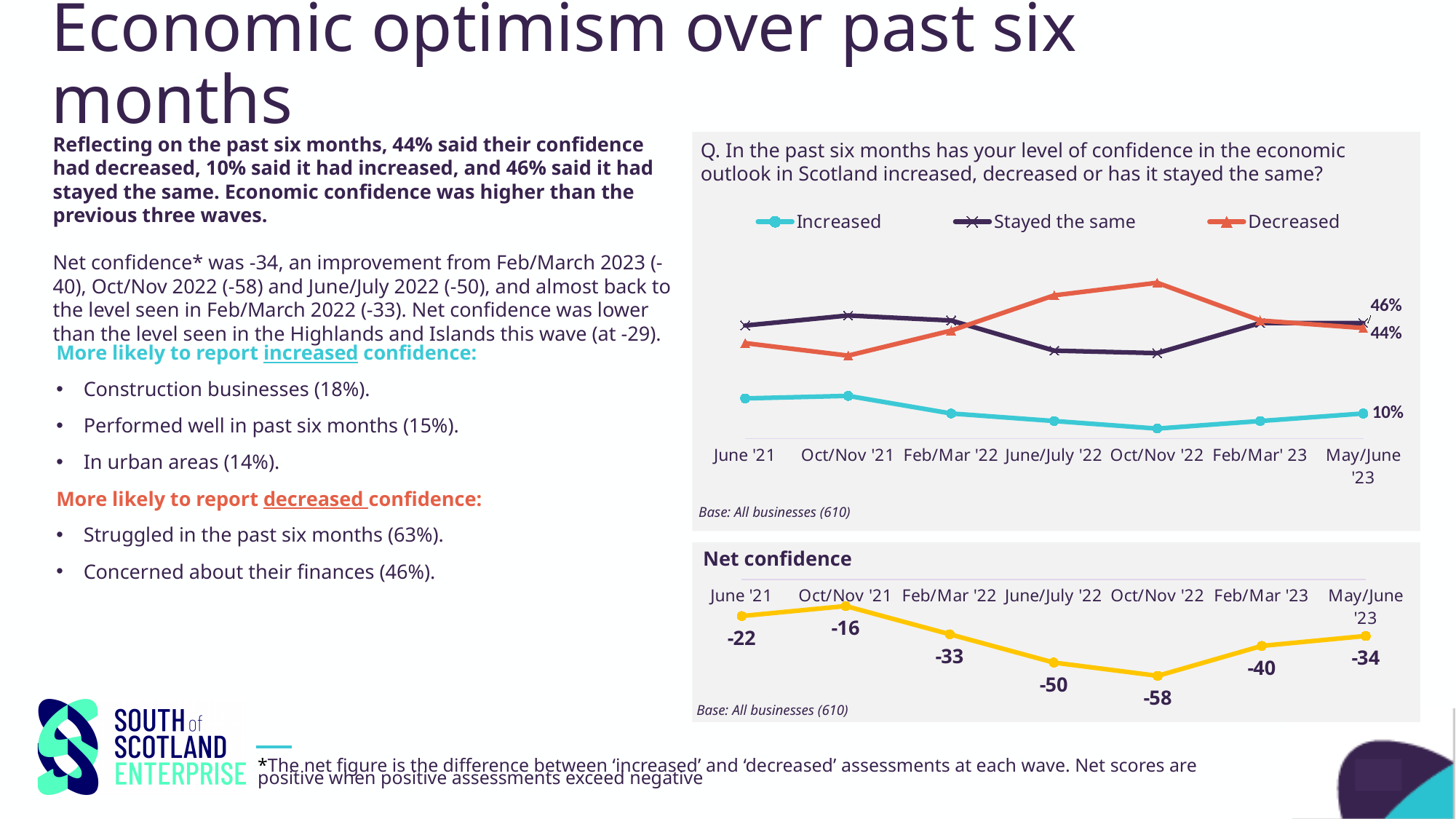
In the Net confidence chart, what is the difference between the Feb/Mar '23 value and the May/June '23 value? 6 In the Net confidence chart, what is the value for June '21? -22 In the Net confidence chart, which wave has the highest net confidence? Oct/Nov '21 In the top chart, what is the value for Increased in May/June '23? 10% In the top chart, what is the value for Decreased in May/June '23? 44% How many series does the legend of the top chart list? 3 In the Net confidence chart, which wave has the lowest net confidence? Oct/Nov '22 In the Net confidence chart, which is larger, the value for Feb/Mar '22 or the value for June/July '22? Feb/Mar '22 In the top chart, which series has the highest value in May/June '23? Stayed the same In the Net confidence chart, what is the value for Oct/Nov '22? -58 How many waves are plotted in the Net confidence chart? 7 What type of chart is the Net confidence chart? Line chart